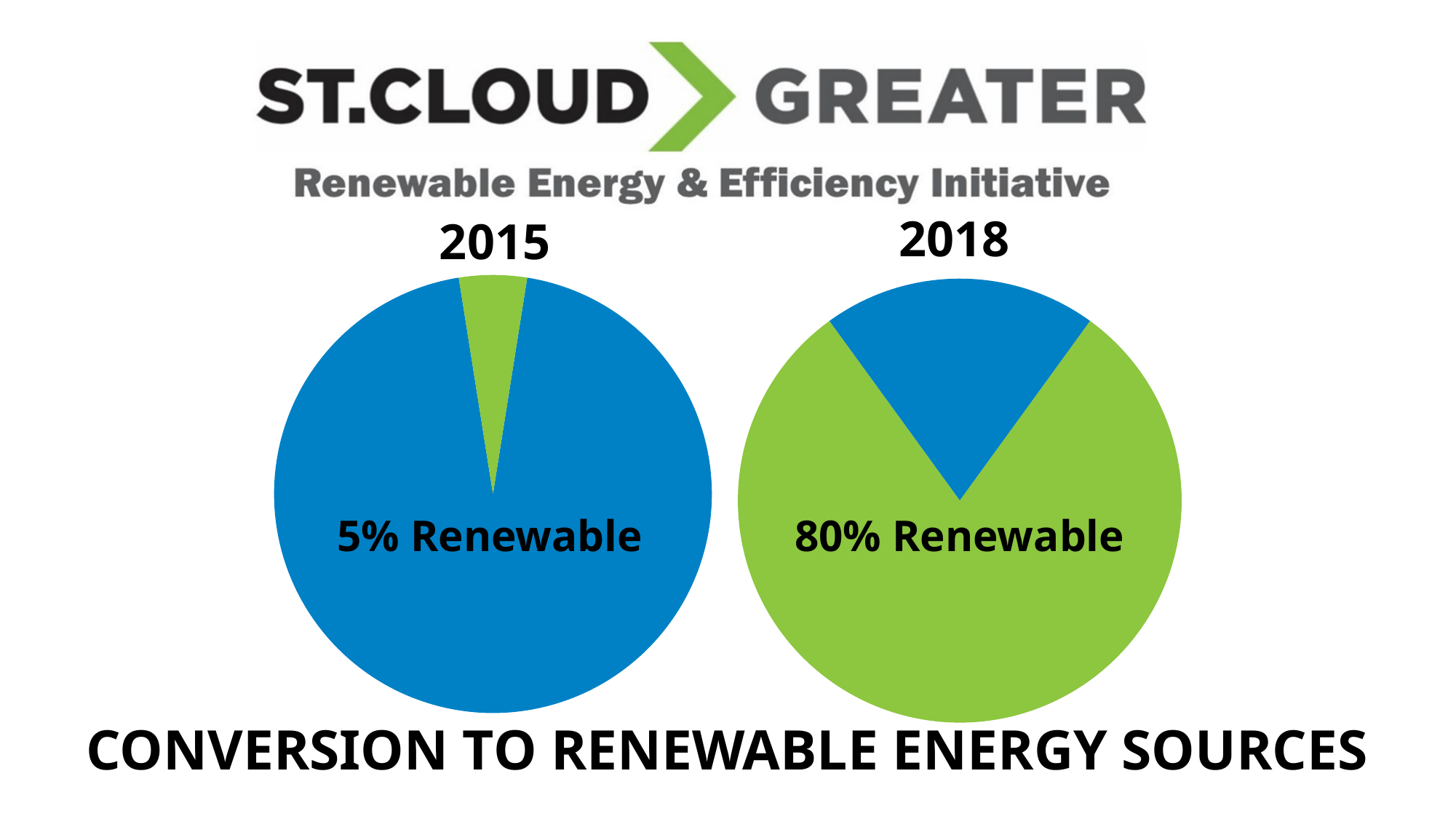
In the 2018 pie chart, is the renewable slice larger or smaller than the non-renewable slice? Larger Which year's pie chart shows the larger renewable share, 2015 or 2018? 2018 In the 2015 pie chart, what share of energy is renewable? 5% Renewable How many pie charts are on the slide? 2 By how many percentage points did the renewable share increase from the 2015 pie chart to the 2018 pie chart? 75 What kind of charts are shown on the slide? Pie charts In the 2015 pie chart, which colour represents the renewable slice? Green What is the caption printed below the two pie charts? CONVERSION TO RENEWABLE ENERGY SOURCES How many slices does each pie chart have? 2 Which year's pie chart shows the smaller renewable share, 2015 or 2018? 2015 In the 2018 pie chart, what share of energy is renewable? 80% Renewable Does the renewable share rise or fall from the 2015 pie chart to the 2018 pie chart? Rise